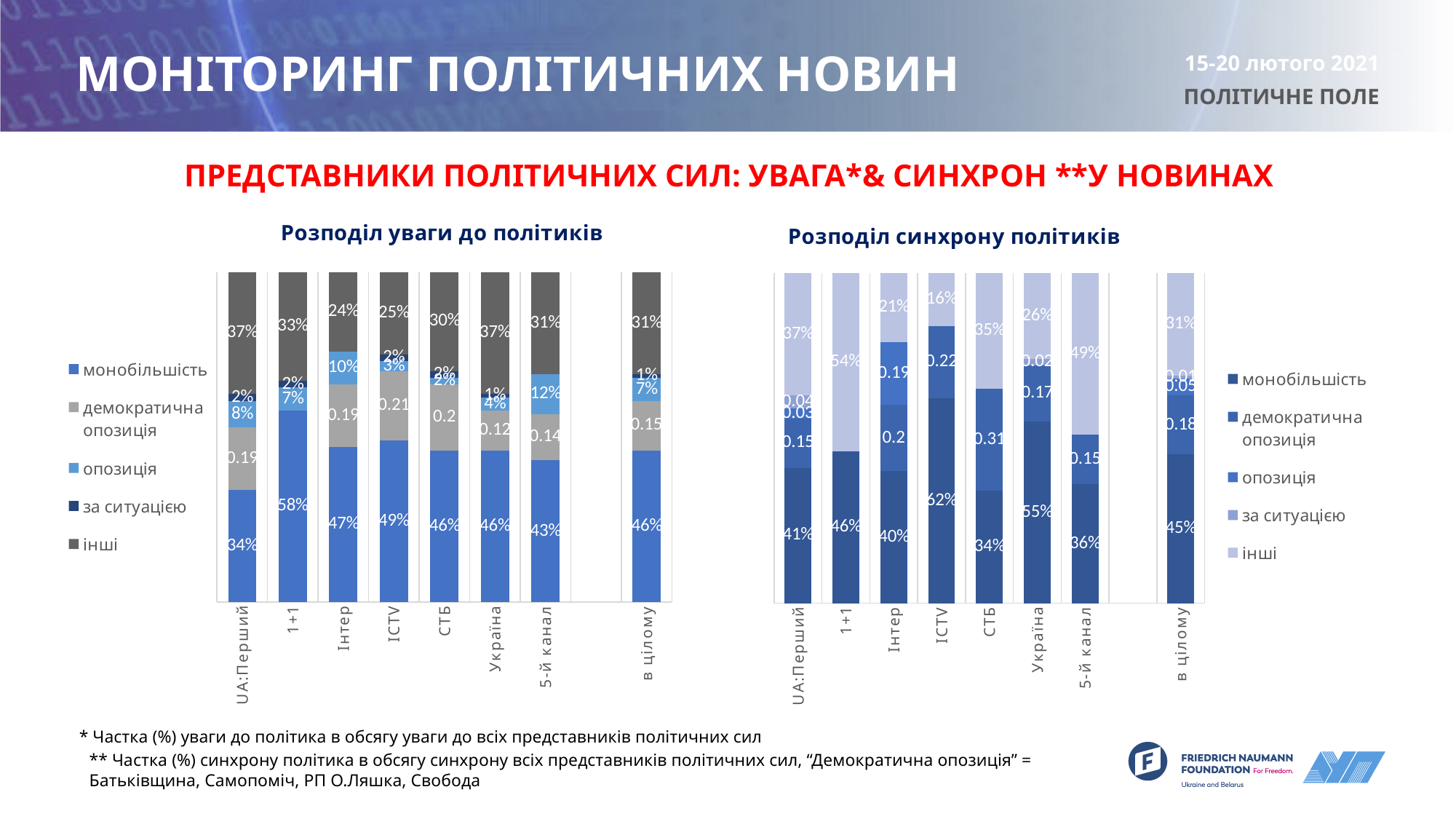
How many channel categories are shown on the x axis of the chart 'Розподіл уваги до політиків'? 8 In the chart 'Розподіл уваги до політиків', which channel has the lowest value for монобільшість? UA:Перший In the chart 'Розподіл уваги до політиків', what is the value for монобільшість on 1+1? 58% In the chart 'Розподіл уваги до політиків', what is the value for інші on Інтер? 24% In the chart 'Розподіл синхрону політиків', what is the value for монобільшість on ICTV? 62% In the chart 'Розподіл синхрону політиків', what is the value for інші on 5-й канал? 49% In the chart 'Розподіл уваги до політиків', which channel has the highest value for монобільшість? 1+1 What kind of chart is 'Розподіл уваги до політиків'? Stacked bar chart In the chart 'Розподіл синхрону політиків', what is the difference in монобільшість between ICTV and СТБ? 28 percentage points In the chart 'Розподіл уваги до політиків', which is larger for інші: UA:Перший or Інтер? UA:Перший In the chart 'Розподіл синхрону політиків', which channel has the lowest value for монобільшість? СТБ How many series does the legend of the chart 'Розподіл синхрону політиків' list? 5